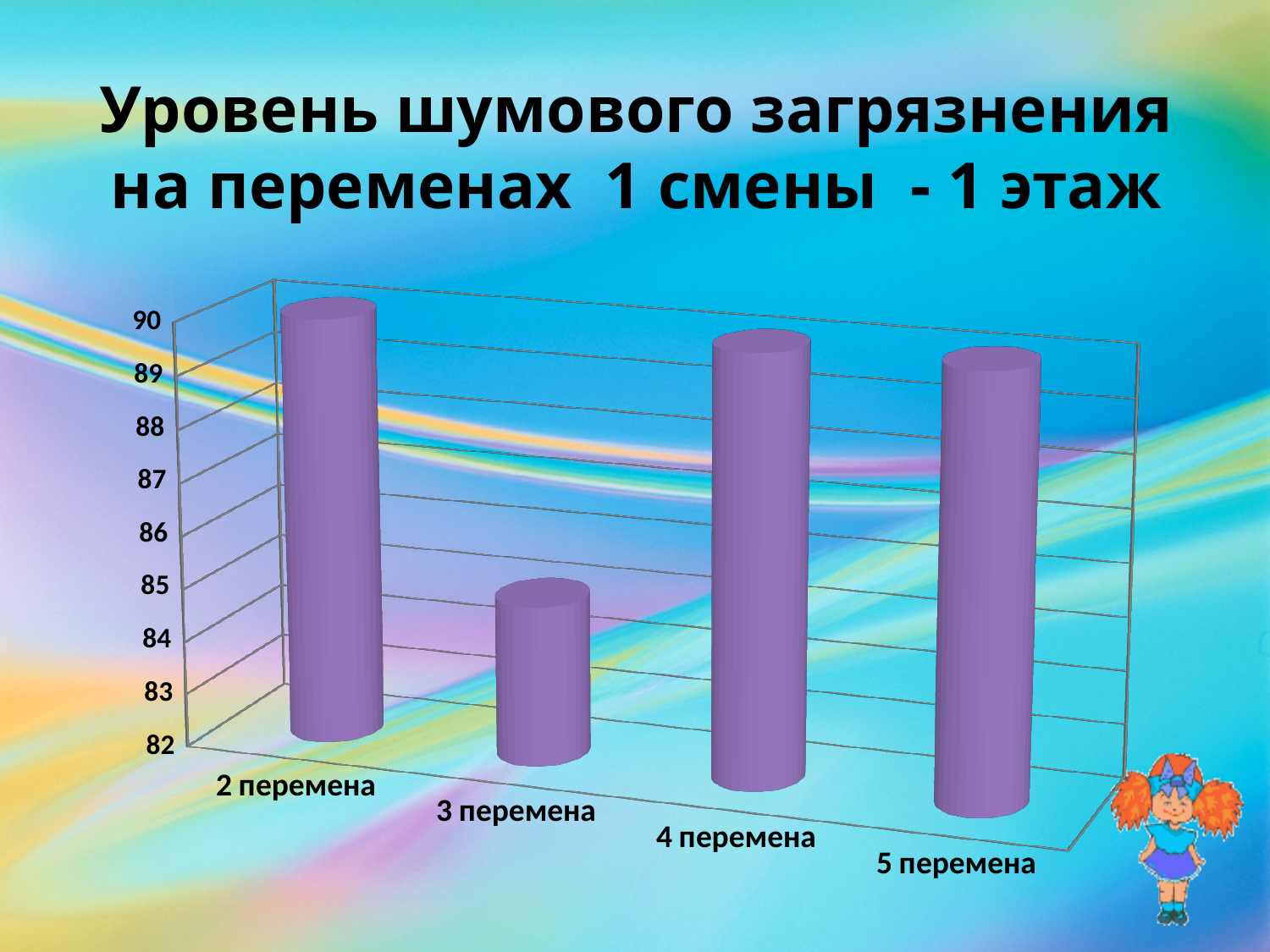
Does the value rise or fall from 2 перемена to 3 перемена? fall Is the value for 5 перемена greater or less than 85? greater Is the value for 2 перемена greater or less than 88? greater What kind of chart is shown on the slide? bar chart Which перемена has the lowest noise level on the chart? 3 перемена Which is larger, the value for 2 перемена or the value for 3 перемена? 2 перемена Is the value for 4 перемена greater or less than 86? greater What is the title of the chart on the slide? Уровень шумового загрязнения на переменах 1 смены - 1 этаж Which is larger, the value for 3 перемена or the value for 4 перемена? 4 перемена How many categories (перемены) are plotted on the chart? 4